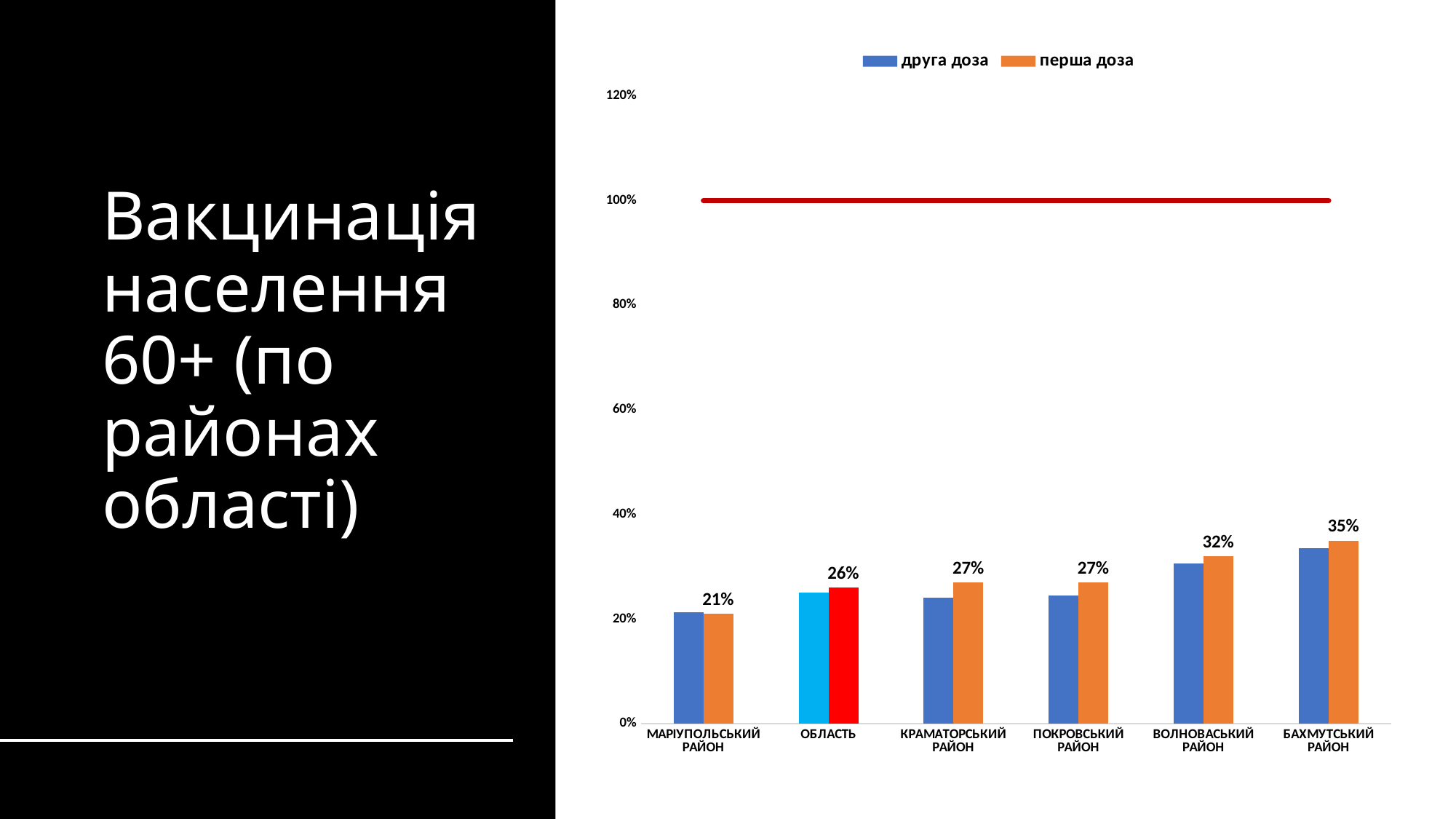
What is the value of перша доза for Маріупольський район? 21% What is the value of перша доза for Область? 26% What kind of chart is shown on the slide? bar chart Which category has the highest перша доза value? Бахмутський район How many series does the legend list? 2 Is the друга доза value for Бахмутський район greater or less than 40%? less How many categories are shown on the x axis? 6 Which category has the lowest перша доза value? Маріупольський район What is the difference between the перша доза values for Бахмутський район and Маріупольський район? 14% What is the value of перша доза for Бахмутський район? 35% Which is larger: the перша доза value for Волноваський район or for Область? Волноваський район At what level is the red horizontal line drawn on the chart? 100%